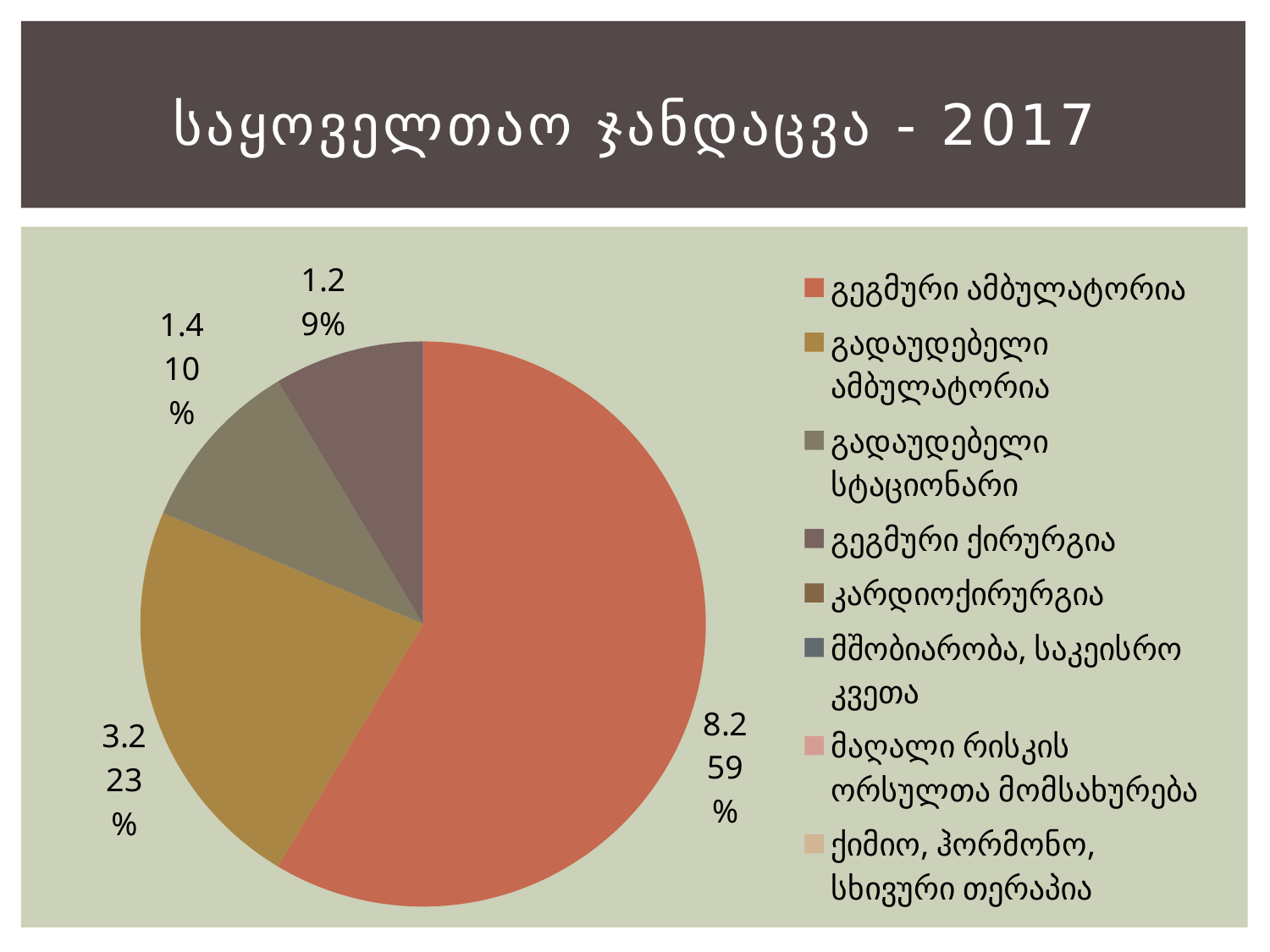
What value is shown for გეგმური ამბულატორია? 8.2 Which of the labelled slices is the smallest? გეგმური ქირურგია Which is larger, the slice for გადაუდებელი სტაციონარი or the slice for გადაუდებელი ამბულატორია? გადაუდებელი ამბულატორია What value is shown for გადაუდებელი ამბულატორია? 3.2 What value is shown for გეგმური ქირურგია? 1.2 What type of chart is shown on the slide? pie chart How many entries does the chart legend list? 8 What percentage share does გადაუდებელი სტაციონარი have in the pie? 10% Which category has the largest slice of the pie? გეგმური ამბულატორია What is the title of the chart on the slide? საყოველთაო ჯანდაცვა - 2017 What is the difference between the values for გეგმური ამბულატორია and გადაუდებელი ამბულატორია? 5.0 What percentage share does გეგმური ამბულატორია have in the pie? 59%